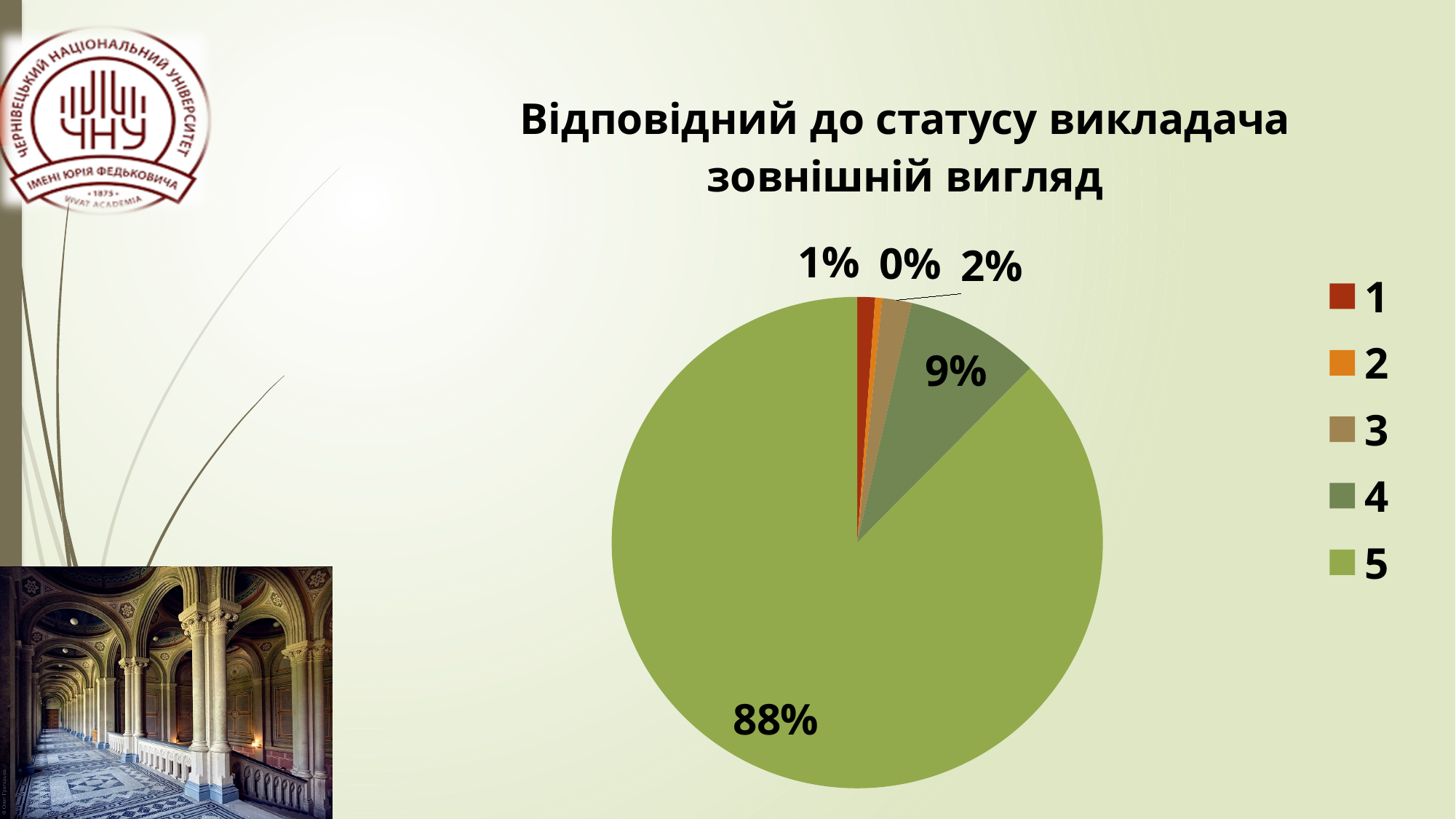
What share of the pie does category 4 have? 9% Which category has the largest slice of the pie? 5 How many categories does the legend list? 5 What share of the pie does category 1 have? 1% Which category has the smallest slice of the pie? 2 What share of the pie does category 2 have? 0% What share of the pie does category 3 have? 2% What is the title of the chart? Відповідний до статусу викладача зовнішній вигляд What is the difference between the shares of category 5 and category 4? 79% Which is larger, the share of category 4 or the share of category 3? 4 What kind of chart is shown on the slide? pie chart What share of the pie does category 5 have? 88%